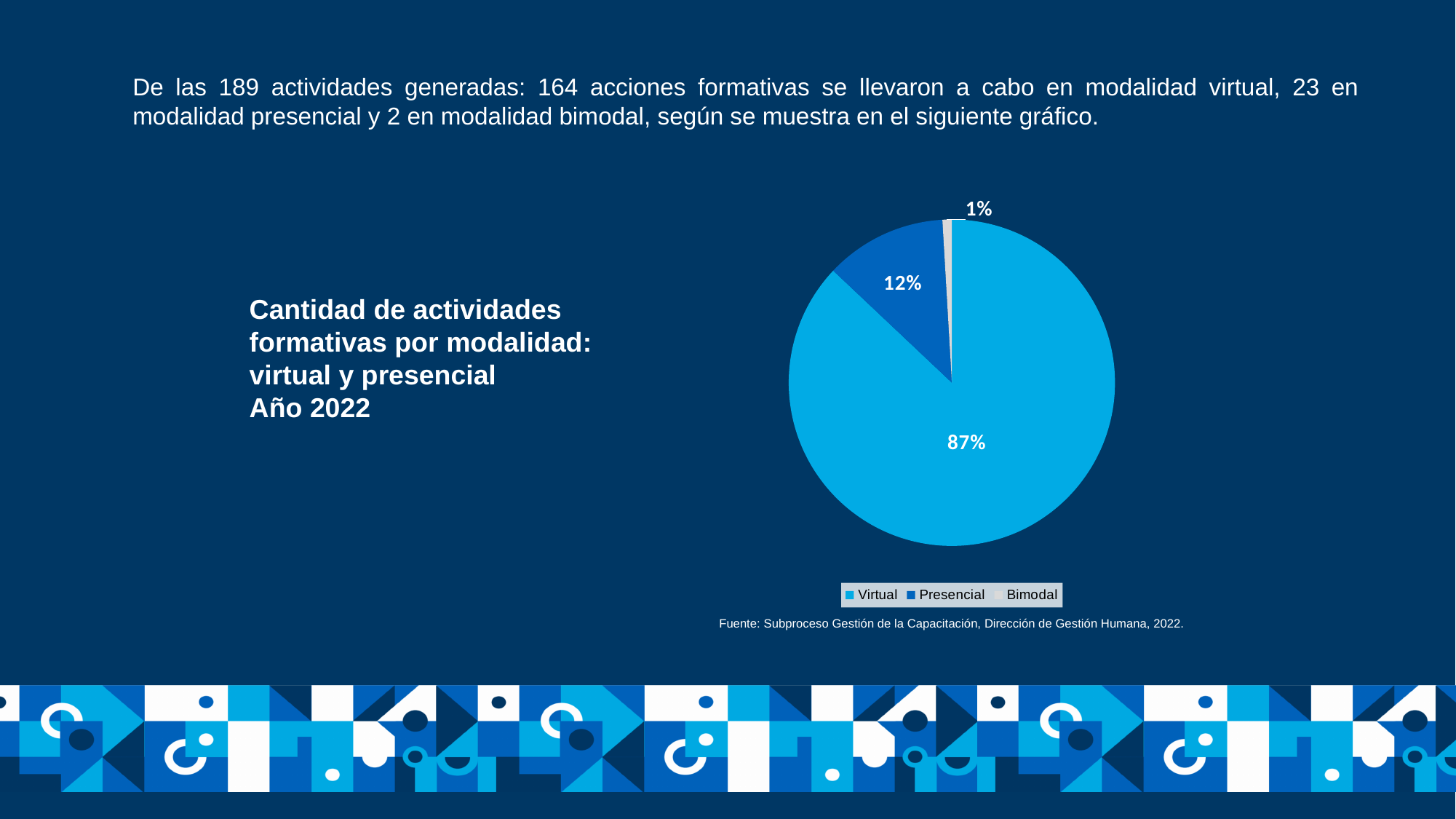
What share of the pie does Virtual represent? 87% Which modality has the largest slice of the pie? Virtual What is the title of the chart? Cantidad de actividades formativas por modalidad: virtual y presencial Año 2022 What share of the pie does Bimodal represent? 1% How many entries does the legend list? 3 What is the difference in percentage points between the Virtual and Presencial slices? 75 Which legend entry is shown in the lightest grey colour? Bimodal How many slices does the pie chart have? 3 Which modality has the smallest slice of the pie? Bimodal What share of the pie does Presencial represent? 12% Which slice is larger, Presencial or Bimodal? Presencial What kind of chart is shown on the slide? pie chart